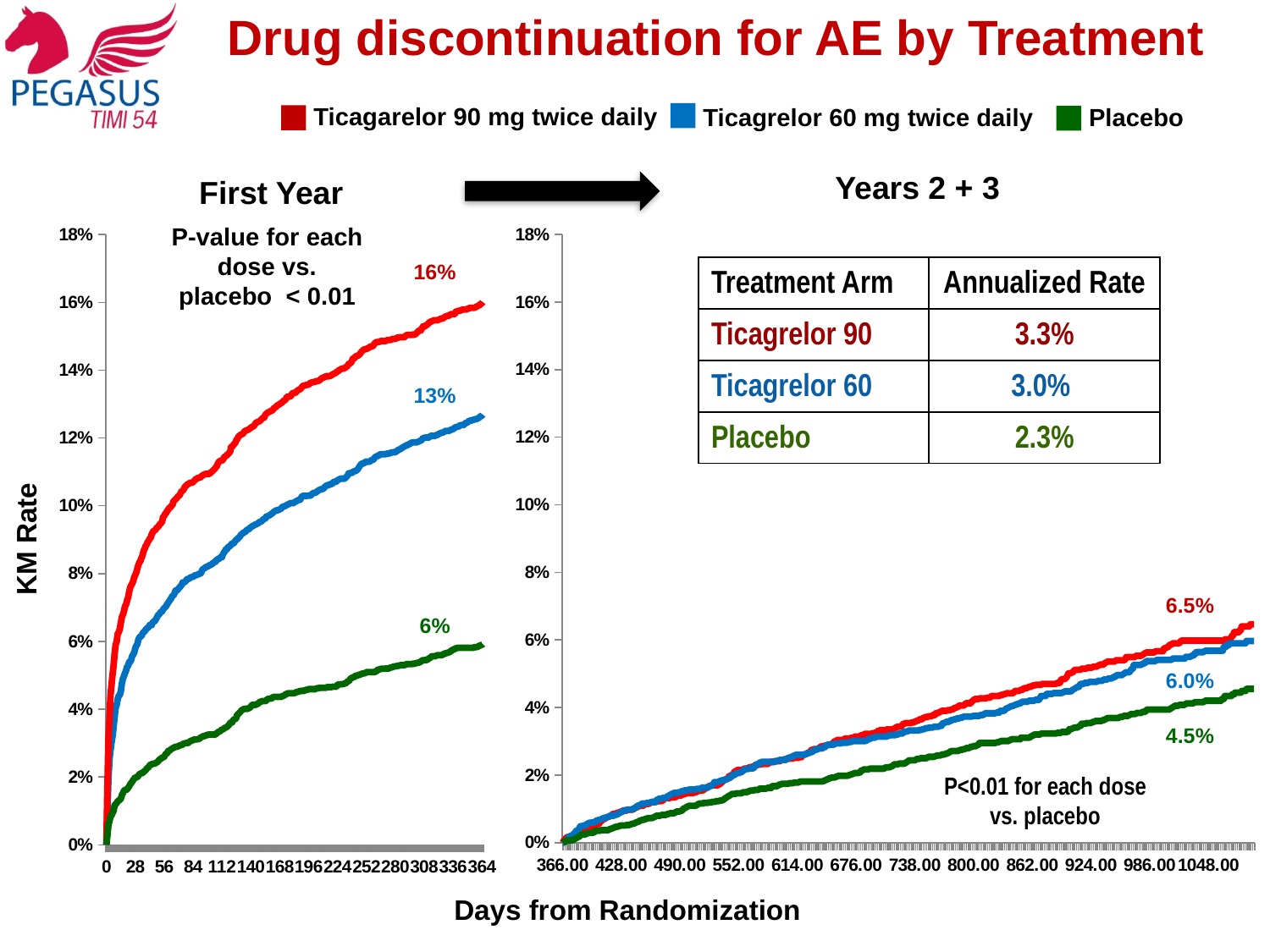
In the First Year chart, what is the KM rate labelled for Ticagrelor 90 mg twice daily at the end of the first year? 16% In the First Year chart, what is the difference between the labelled end-of-year KM rates for Ticagrelor 90 mg and Ticagrelor 60 mg? 3% In the Years 2 + 3 chart, which treatment arm has the lowest KM rate at the end of the curve? Placebo In the First Year chart, what is the KM rate labelled for Placebo at the end of the first year? 6% In the Years 2 + 3 chart, which is larger at the end of the curve: the KM rate for Ticagrelor 90 mg or for Ticagrelor 60 mg? Ticagrelor 90 mg In the Years 2 + 3 chart, what is the KM rate labelled for Ticagrelor 60 mg twice daily at the end of the curve? 6.0% In the First Year chart, is the KM rate for Placebo at day 364 greater or less than 4%? greater In the First Year chart, which treatment arm has the highest KM rate at the end of the first year? Ticagrelor 90 mg twice daily How many series does the legend at the top of the slide list? 3 In the Years 2 + 3 chart, what is the KM rate labelled for Placebo at the end of the curve? 4.5% In the Years 2 + 3 chart, what is the difference between the labelled KM rates for Ticagrelor 90 mg and Placebo? 2.0% What kind of chart is the First Year chart? Line chart